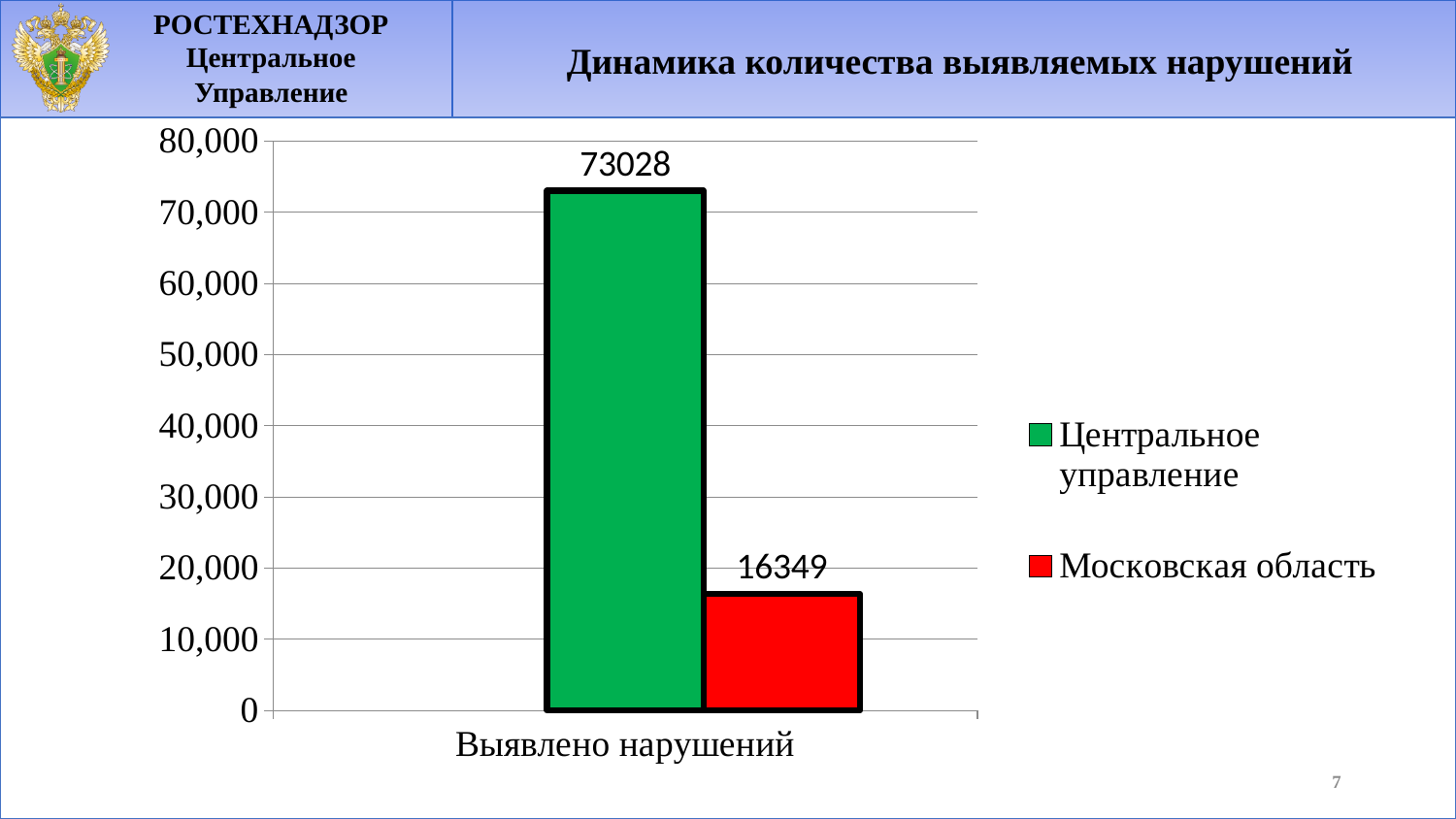
What is the value for Московская область? 16349 Which is larger, the value for Центральное управление or for Московская область? Центральное управление What is the category label on the x axis? Выявлено нарушений Which series has the lowest value? Московская область What is the difference between the values for Центральное управление and Московская область? 56679 What colour is the bar for Московская область? red Is the value for Московская область greater or less than 20,000? less How many series does the legend list? 2 Is the value for Центральное управление greater or less than 70,000? greater What is the value for Центральное управление? 73028 What kind of chart is shown? bar chart Which series has the highest value? Центральное управление